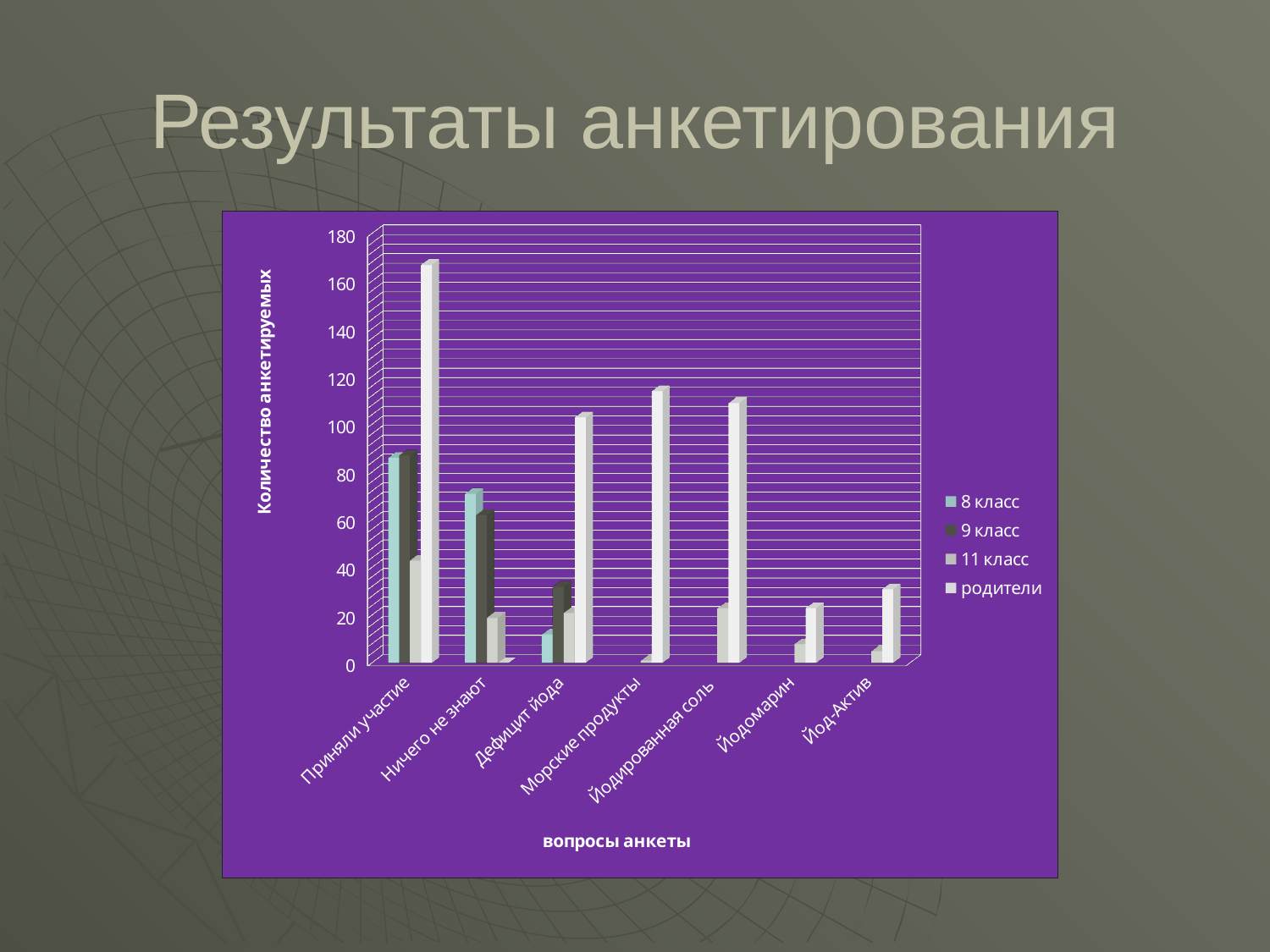
Is the value for 8 класс in the Ничего не знают category greater or less than 60? greater Is the value for родители in the Йод-Актив category greater or less than 40? less How many series does the legend list? 4 How many categories are shown along the x axis? 7 What is the title of the vertical axis? Количество анкетируемых Is the value for родители in the Приняли участие category greater or less than 140? greater What is the title of the horizontal axis? вопросы анкеты Which is larger: the родители value for Приняли участие or the родители value for Ничего не знают? Приняли участие What kind of chart is shown on the slide? bar chart Which category has the highest value for the родители series? Приняли участие